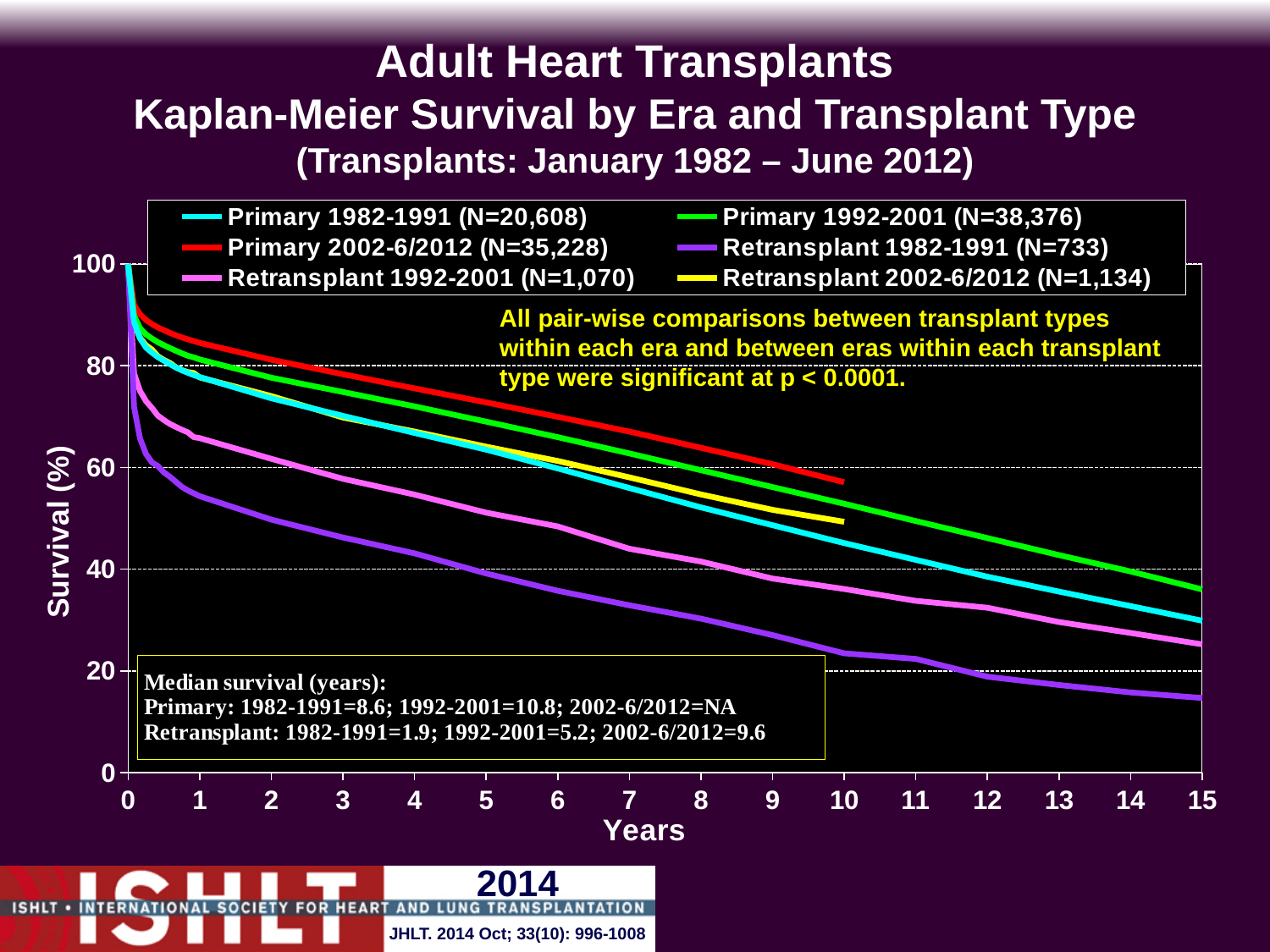
Which series has the lowest survival curve across the chart? Retransplant 1982-1991 What kind of chart is shown on the slide? line chart What is the N for the Primary 2002-6/2012 series in the legend? 35,228 Is the survival for Retransplant 1982-1991 at 15 years greater or less than 20? less At 10 years, which is higher: Primary 2002-6/2012 or Retransplant 2002-6/2012? Primary 2002-6/2012 How many series does the legend list? 6 What is the median survival in years for Retransplant 1982-1991? 1.9 Is the survival for Primary 1992-2001 at 15 years greater or less than 40? less What is the difference in median survival (years) between Primary 1992-2001 and Primary 1982-1991? 2.2 Do the survival curves rise or fall as years increase? fall Which series has the highest survival curve across the chart? Primary 2002-6/2012 What is the median survival in years for Primary 1992-2001 transplants? 10.8